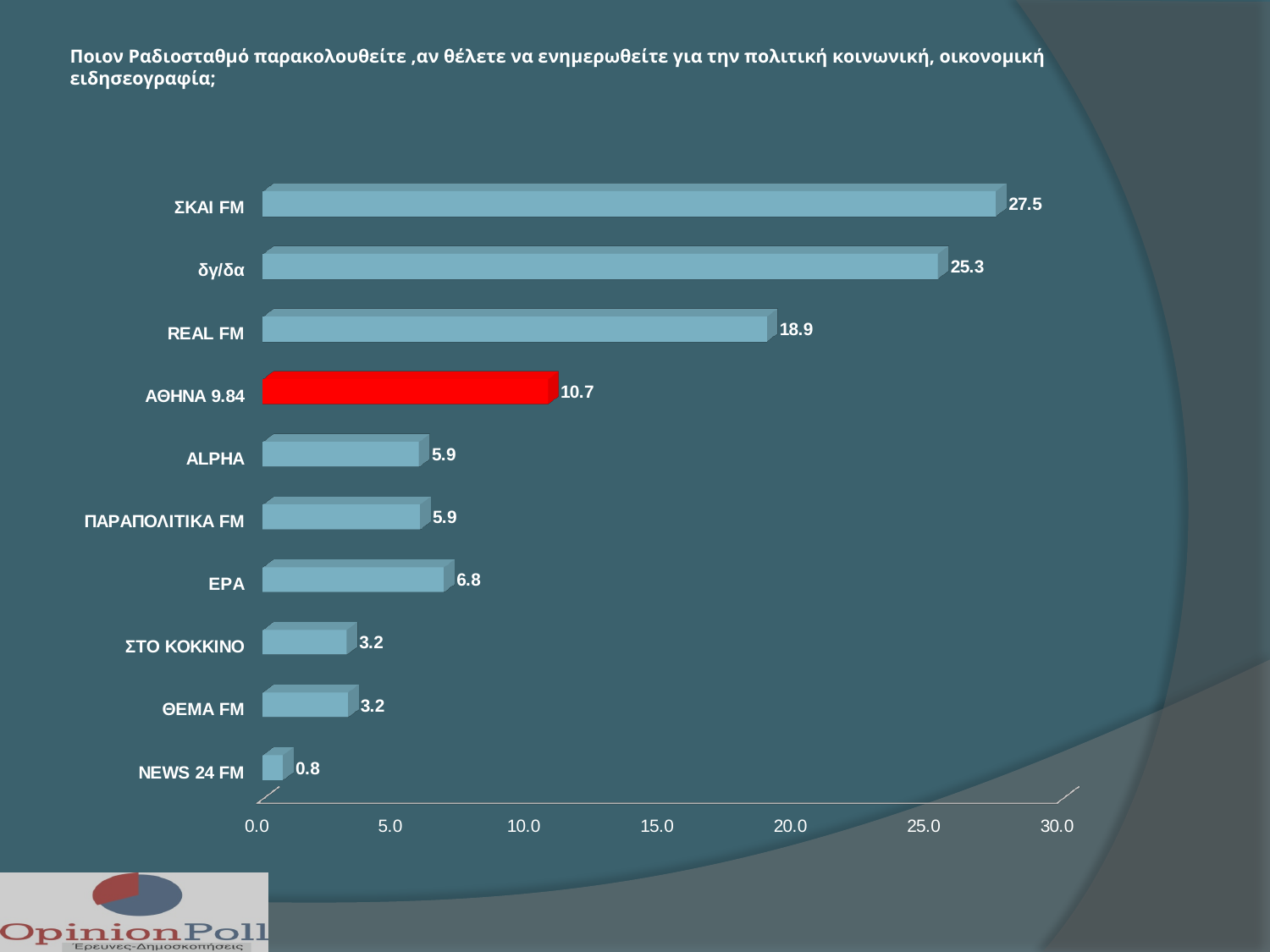
Which category has the highest value? ΣΚΑΙ FM What is the value for ΕΡΑ? 6.8 What is the difference between the values for δγ/δα and ΑΘΗΝΑ 9.84? 14.6 Is the value for δγ/δα greater or less than 20.0? greater What is the value for ΣΚΑΙ FM? 27.5 Which category has the lowest value? NEWS 24 FM What kind of chart is shown on the slide? bar chart What is the value for ΑΘΗΝΑ 9.84? 10.7 How many categories are shown in the chart? 10 Which bar is coloured red? ΑΘΗΝΑ 9.84 Which is larger, the value for REAL FM or the value for ΑΘΗΝΑ 9.84? REAL FM What is the difference between the values for ΣΚΑΙ FM and REAL FM? 8.6